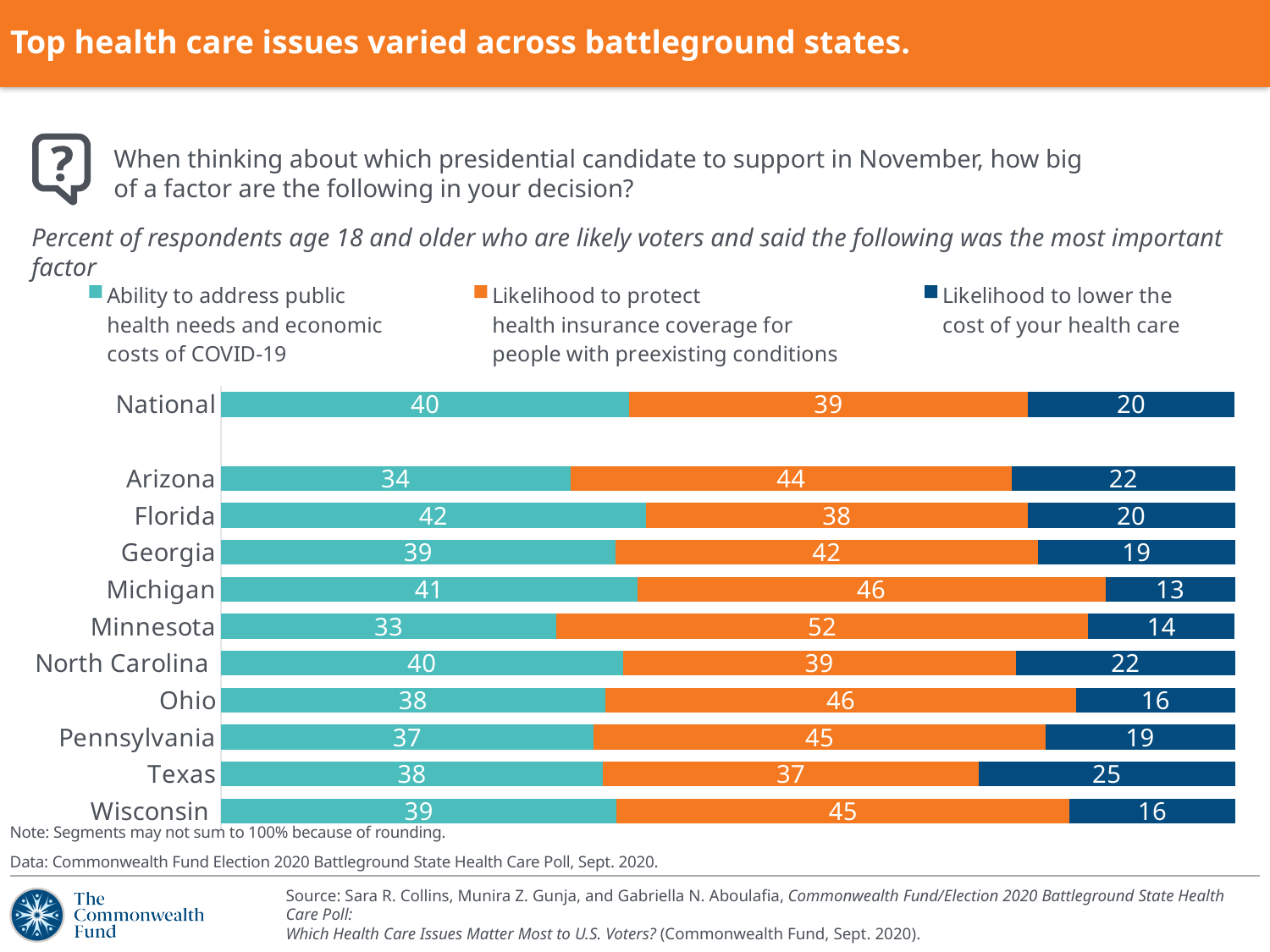
What kind of chart is shown on the slide? Stacked bar chart What is the value for Texas for the likelihood to lower the cost of your health care? 25 In Arizona, what is the difference between the value for protecting coverage for preexisting conditions and the value for addressing COVID-19? 10 Which has a larger value for the ability to address COVID-19: Michigan or Ohio? Michigan What percentage of likely voters in Minnesota said the likelihood to protect health insurance coverage for people with preexisting conditions was the most important factor? 52 Which state has the highest value for the likelihood to protect health insurance coverage for people with preexisting conditions? Minnesota How many series does the legend list? 3 What is the total of the three segments in the Texas bar? 100 Which state has the highest value for the ability to address public health needs and economic costs of COVID-19? Florida How many categories (bars) are shown in the chart? 11 Which state has the lowest value for the likelihood to lower the cost of your health care? Michigan What is the National value for the ability to address public health needs and economic costs of COVID-19? 40